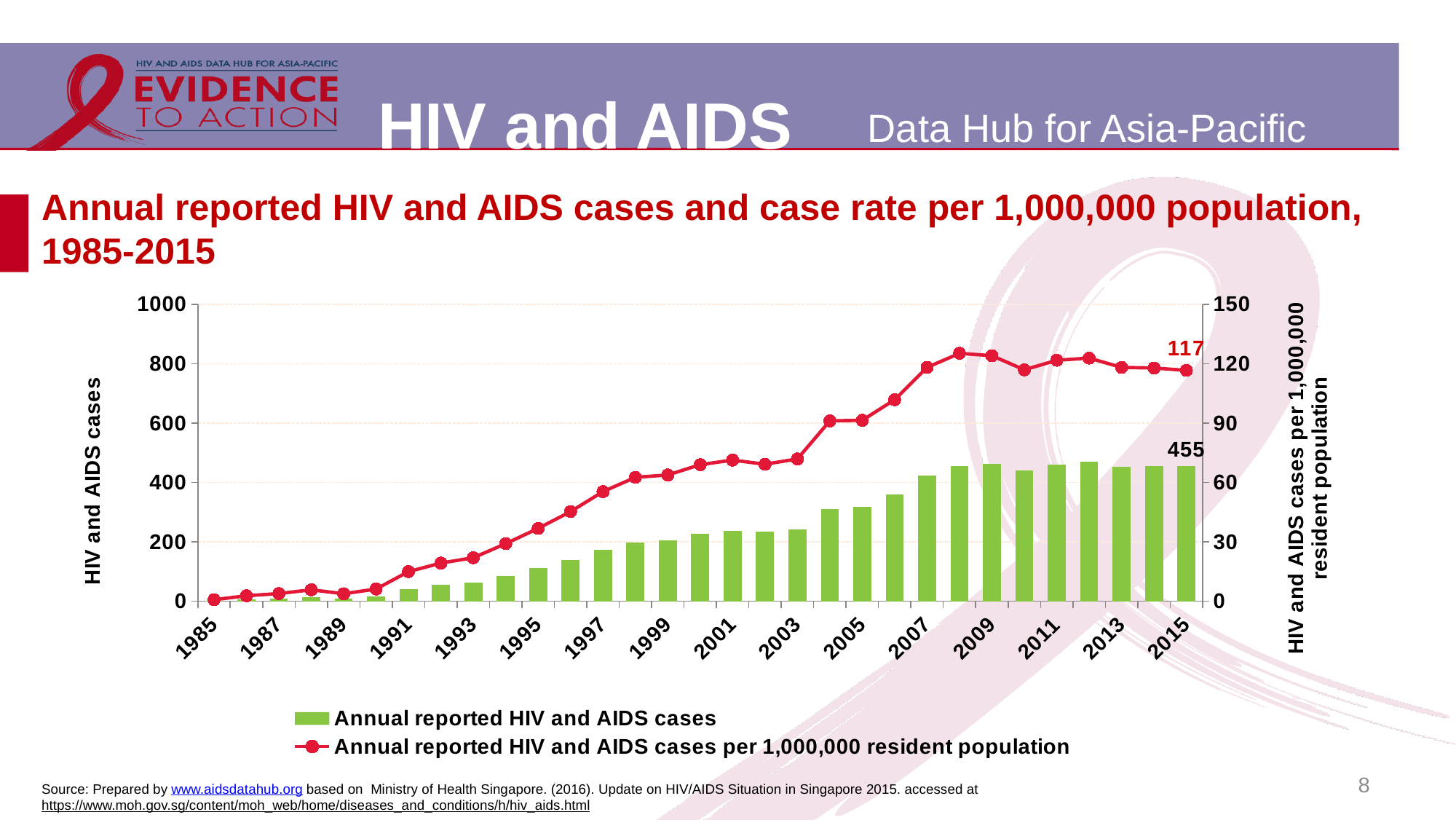
Which year has more annual reported HIV and AIDS cases, 1985 or 2015? 2015 What kind of chart is shown on the slide? Combined bar and line chart What is the value of the data label on the line for 2015 (cases per 1,000,000 resident population)? 117 Is the number of annual reported HIV and AIDS cases for 1995 greater or less than 200? less Overall, do the annual reported HIV and AIDS cases rise or fall from 1985 to 2015? Rise Is the case rate per 1,000,000 resident population for 2001 greater or less than 60? greater What is the value of the data label on the bar for 2015? 455 How many series does the legend list? 2 What colour are the bars representing annual reported HIV and AIDS cases? Green How many years (bars) are plotted on the chart? 31 Is the number of annual reported HIV and AIDS cases for 2009 greater or less than 400? greater